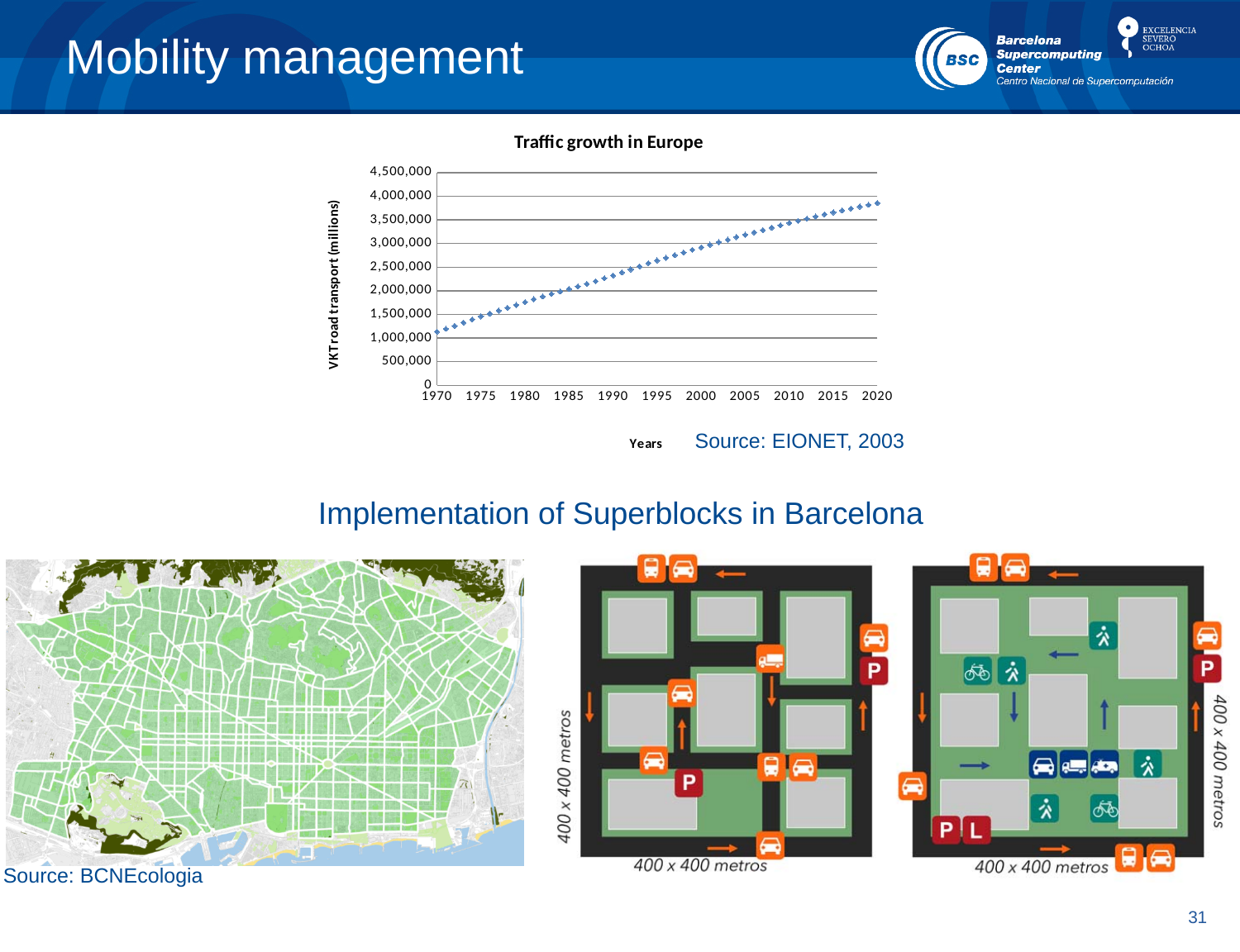
In the Traffic growth in Europe chart, is the value for 2020 greater or less than 3,500,000? greater What kind of chart is the Traffic growth in Europe chart? scatter chart In the Traffic growth in Europe chart, which year has the lowest value? 1970 In the Traffic growth in Europe chart, do the values rise or fall from 1970 to 2020? rise In the Traffic growth in Europe chart, is the value for 1970 greater or less than 1,500,000? less In the Traffic growth in Europe chart, which year has the highest value? 2020 What is the title of the chart on the slide? Traffic growth in Europe In the Traffic growth in Europe chart, is the value for 1980 greater or less than 2,000,000? less In the Traffic growth in Europe chart, which year has the larger value, 1990 or 2010? 2010 What is the label of the vertical axis of the Traffic growth in Europe chart? VKT road transport (millions)